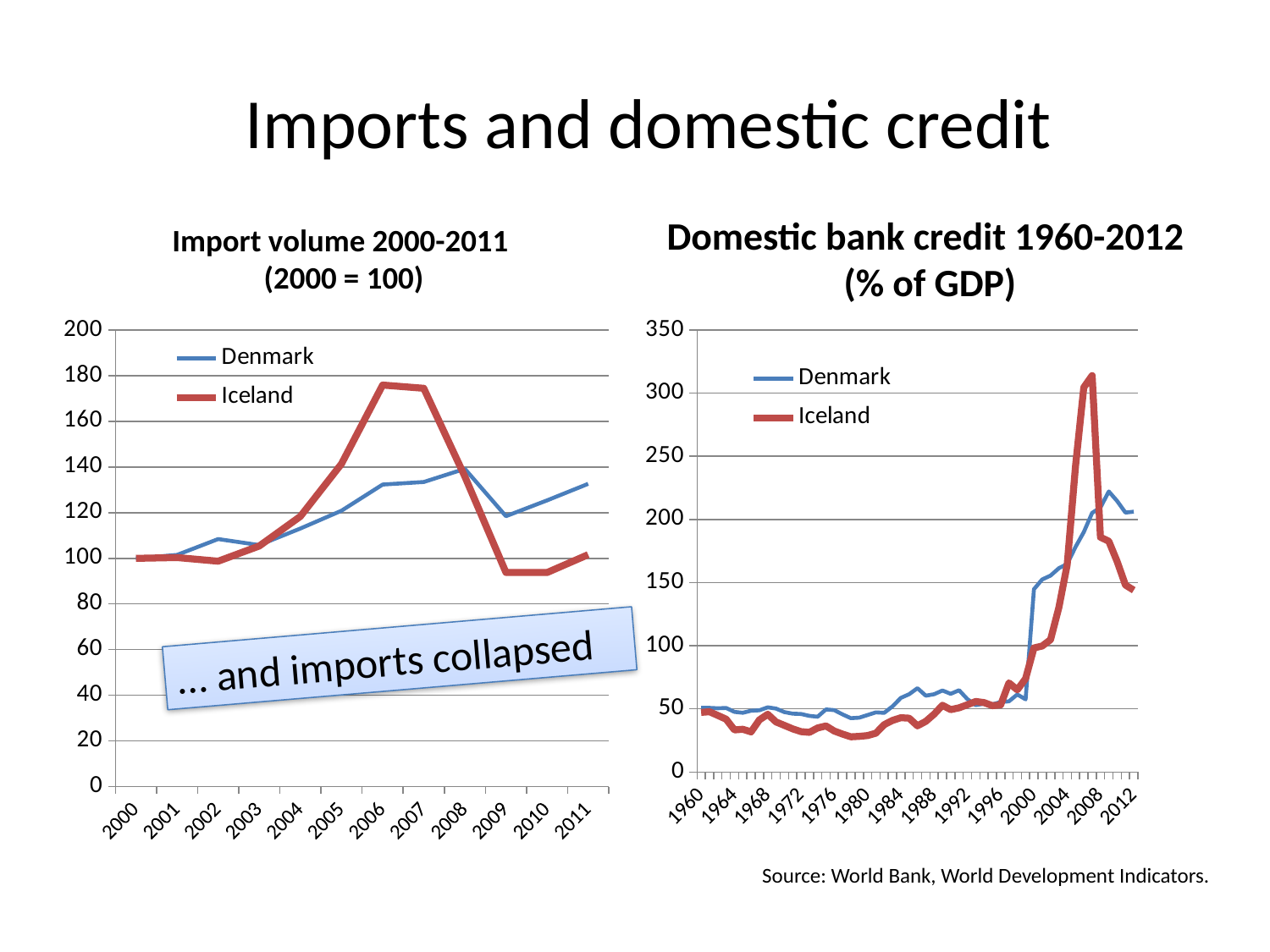
In the 'Import volume 2000-2011' chart, is the value for Iceland in 2006 greater or less than 160? greater In the 'Import volume 2000-2011' chart, in which year does the Iceland series reach its highest value? 2006 What is the source cited at the bottom of the slide? World Bank, World Development Indicators. In the 'Domestic bank credit 1960-2012' chart, which series has the larger value in 2012, Denmark or Iceland? Denmark What type of chart is the 'Import volume 2000-2011' chart? Line chart How many years are plotted along the x axis of the 'Import volume 2000-2011' chart? 12 In the 'Domestic bank credit 1960-2012' chart, does the Iceland series rise or fall between 2008 and 2012? Fall In the 'Import volume 2000-2011' chart, which series has the larger value in 2009, Denmark or Iceland? Denmark In the 'Import volume 2000-2011' chart, what is the value for Iceland in 2000? 100 In the 'Import volume 2000-2011' chart, is the value for Iceland in 2009 greater or less than 100? less In the 'Domestic bank credit 1960-2012' chart, is the peak value for Iceland greater or less than 300? greater How many series does the legend of the 'Domestic bank credit 1960-2012' chart list? 2